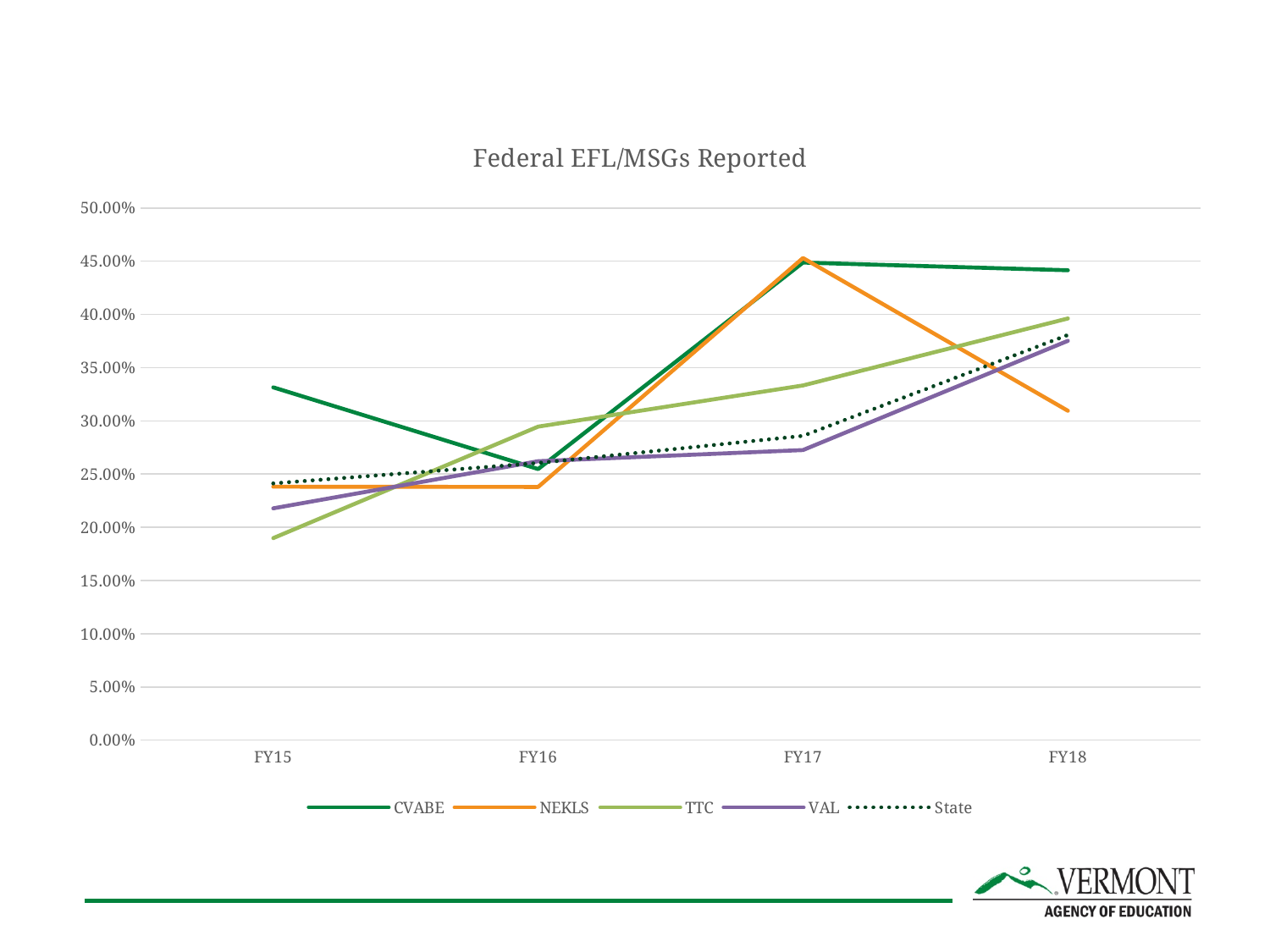
Is the value for CVABE in FY15 greater or less than 30.00%? greater Is the value for VAL in FY15 greater or less than 25.00%? less Which series has the highest value in FY18? CVABE How many series does the legend list? 5 Does the TTC line rise or fall from FY15 to FY18? rises Which series is drawn with a dotted line? State In FY18, which is larger: NEKLS or TTC? TTC Is the value for CVABE in FY17 greater or less than 40.00%? greater How many fiscal years are plotted along the x axis? 4 Which series has the lowest value in FY15? TTC What kind of chart is shown on the slide? line chart